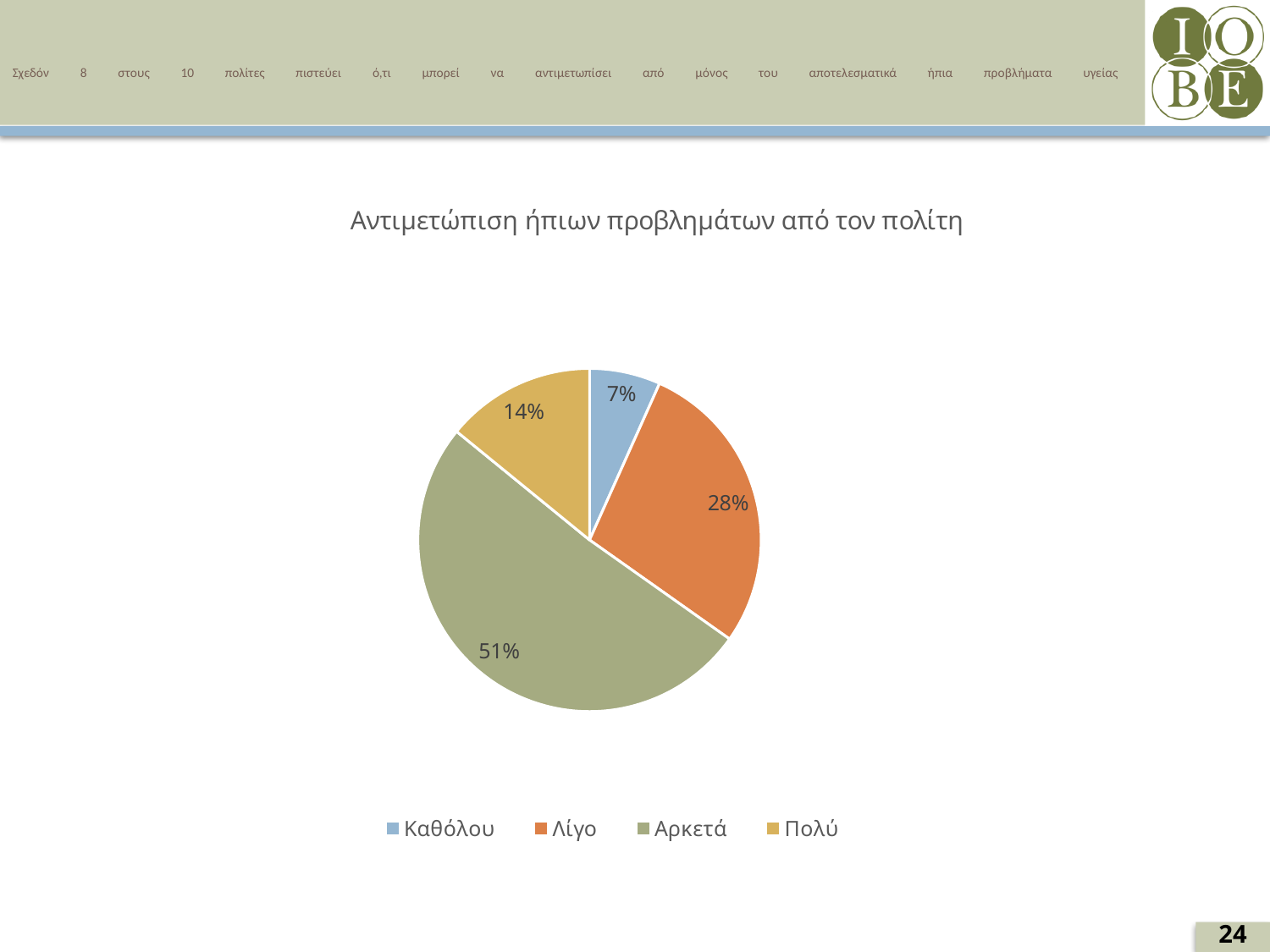
What is the value for Πολύ? 14% What is the value for Καθόλου? 7% Which category has the smallest slice? Καθόλου What is the difference between the values for Αρκετά and Λίγο? 23% What kind of chart is shown on the slide? Pie chart What share of the pie does Αρκετά represent? 51% How many categories does the pie chart show? 4 Which category has the largest slice? Αρκετά What is the title of the chart? Αντιμετώπιση ήπιων προβλημάτων από τον πολίτη What is the value for Λίγο? 28% What is the difference between the values for Πολύ and Καθόλου? 7% Which is larger, Λίγο or Πολύ? Λίγο